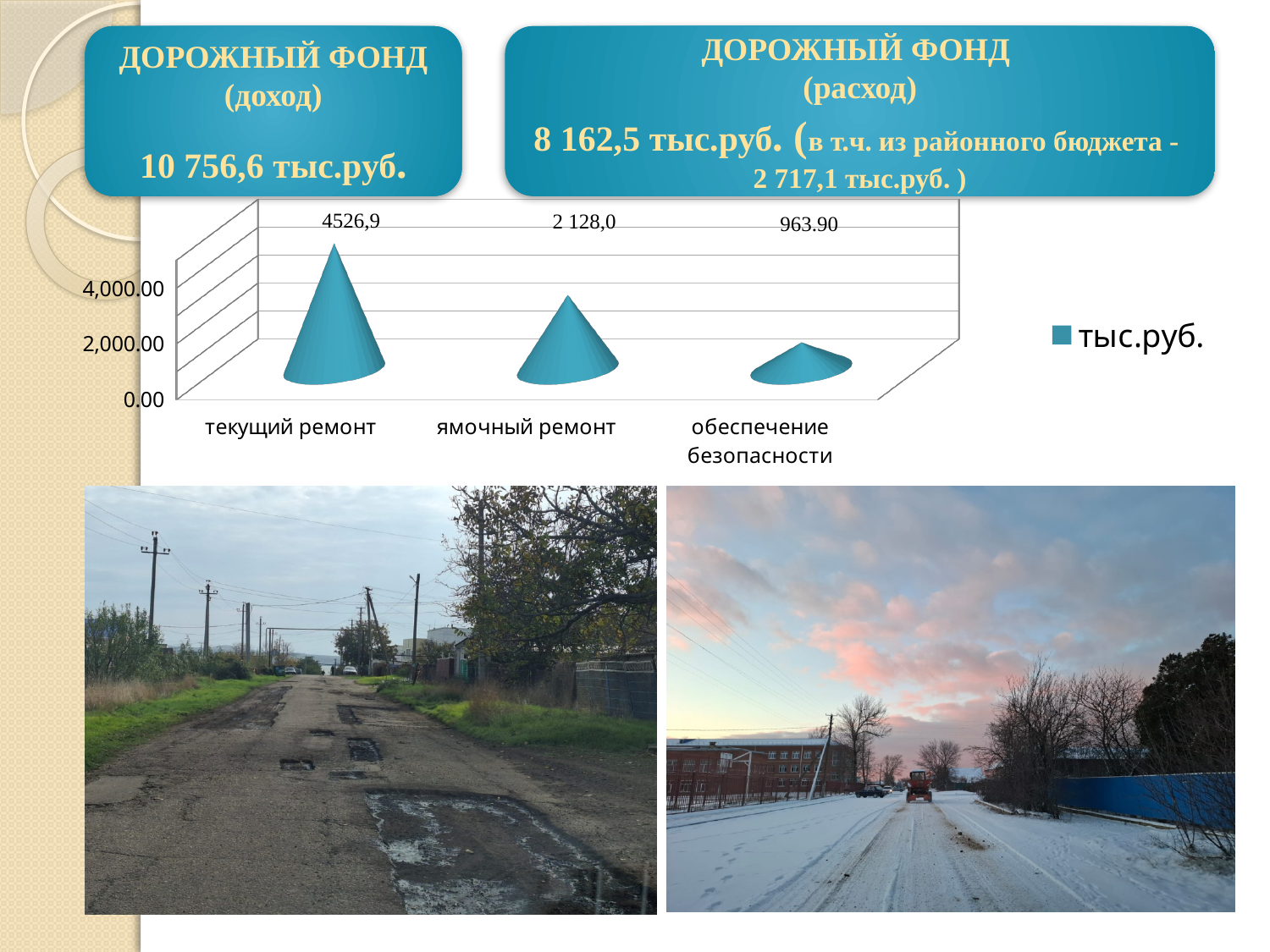
Which category has the highest value? текущий ремонт How many categories are shown on the chart? 3 Which is larger, the value for ямочный ремонт or the value for обеспечение безопасности? ямочный ремонт How many series does the legend list? 1 What is the legend entry of the chart? тыс.руб. Is the value for обеспечение безопасности greater or less than 2,000.00? less Is the value for текущий ремонт greater or less than 4,000.00? greater Which category has the lowest value? обеспечение безопасности What is the value for ямочный ремонт? 2 128,0 What is the value for текущий ремонт? 4526,9 What is the value for обеспечение безопасности? 963.90 Do the values rise or fall from left to right along the x axis? fall